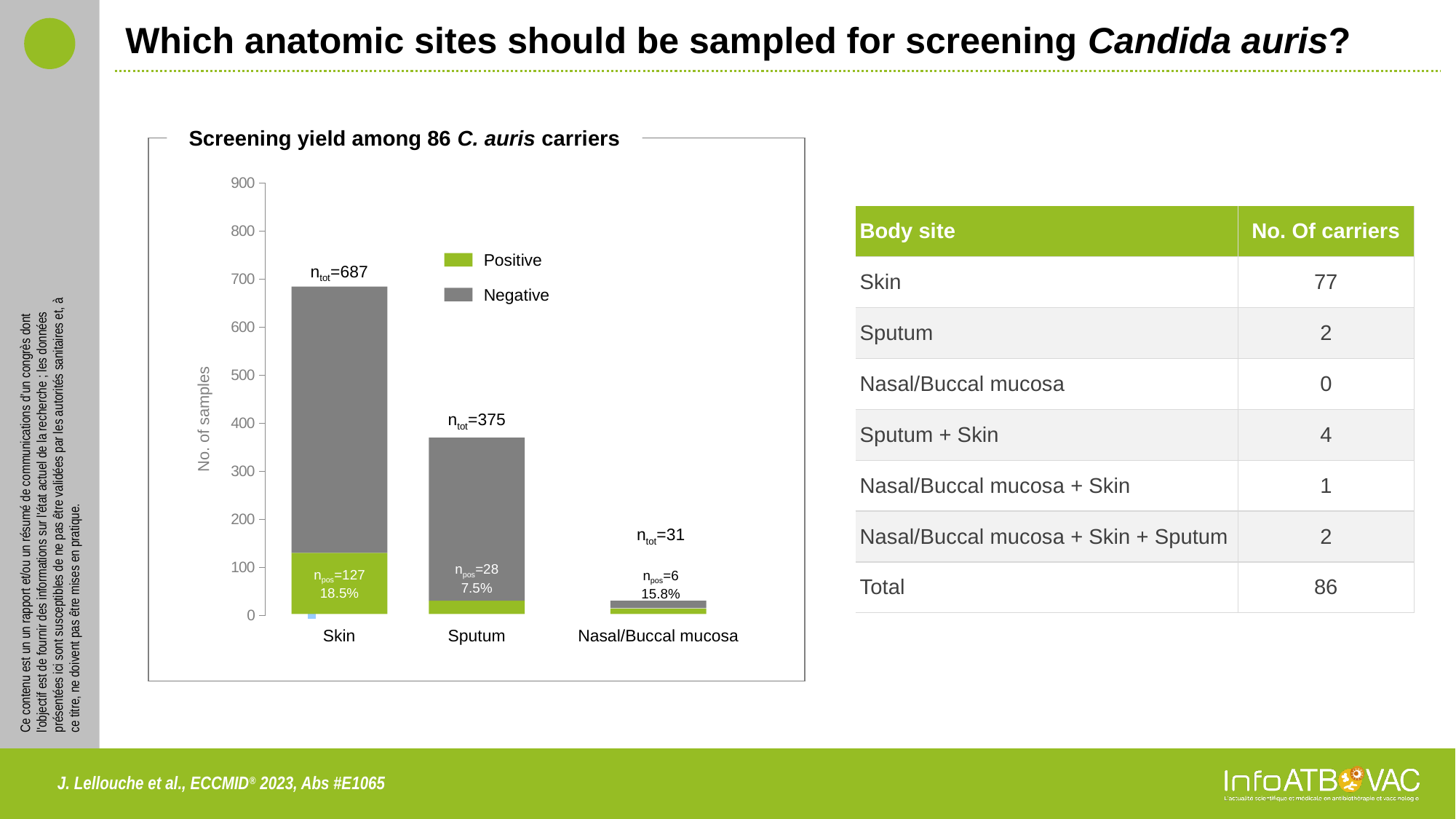
What is the title of the chart? Screening yield among 86 C. auris carriers What percentage of Nasal/Buccal mucosa samples were positive according to the chart? 15.8% What is the number of positive samples (n_pos) for Sputum in the chart? 28 Which anatomic site has the highest total number of samples in the chart? Skin What is the total number of samples (n_tot) for Skin in the chart? 687 What type of chart is shown on the slide? Stacked bar chart Which anatomic site has the lowest number of positive samples in the chart? Nasal/Buccal mucosa Which has a higher positive percentage in the chart, Skin or Sputum? Skin Is the total number of samples for Sputum greater or less than 400? less What is the difference between the total number of samples for Skin and for Sputum? 312 How many anatomic sites (categories) are plotted on the x axis of the chart? 3 How many series does the chart legend list? 2